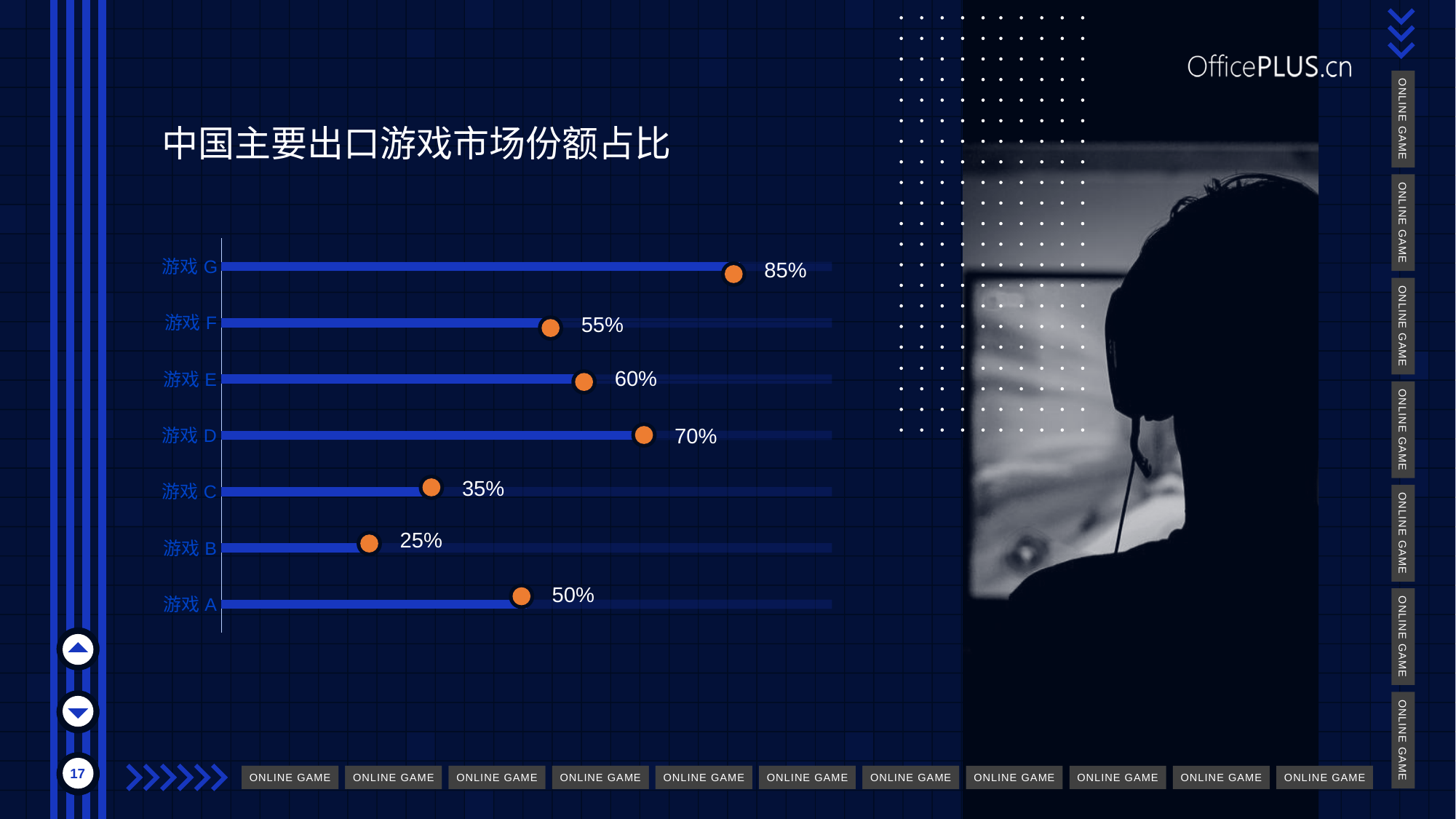
Which category has the highest value? 游戏 G What is the difference between the values for 游戏 G and 游戏 B? 60% What is the difference between the values for 游戏 E and 游戏 F? 5% What is the value for 游戏 B? 25% What is the value for 游戏 G? 85% What is the title of the chart? 中国主要出口游戏市场份额占比 What colour are the markers at the end of each bar? orange Which is larger, the value for 游戏 A or the value for 游戏 C? 游戏 A Which category has the lowest value? 游戏 B What kind of chart is shown on the slide? bar chart How many categories are shown in the chart? 7 What is the value for 游戏 D? 70%